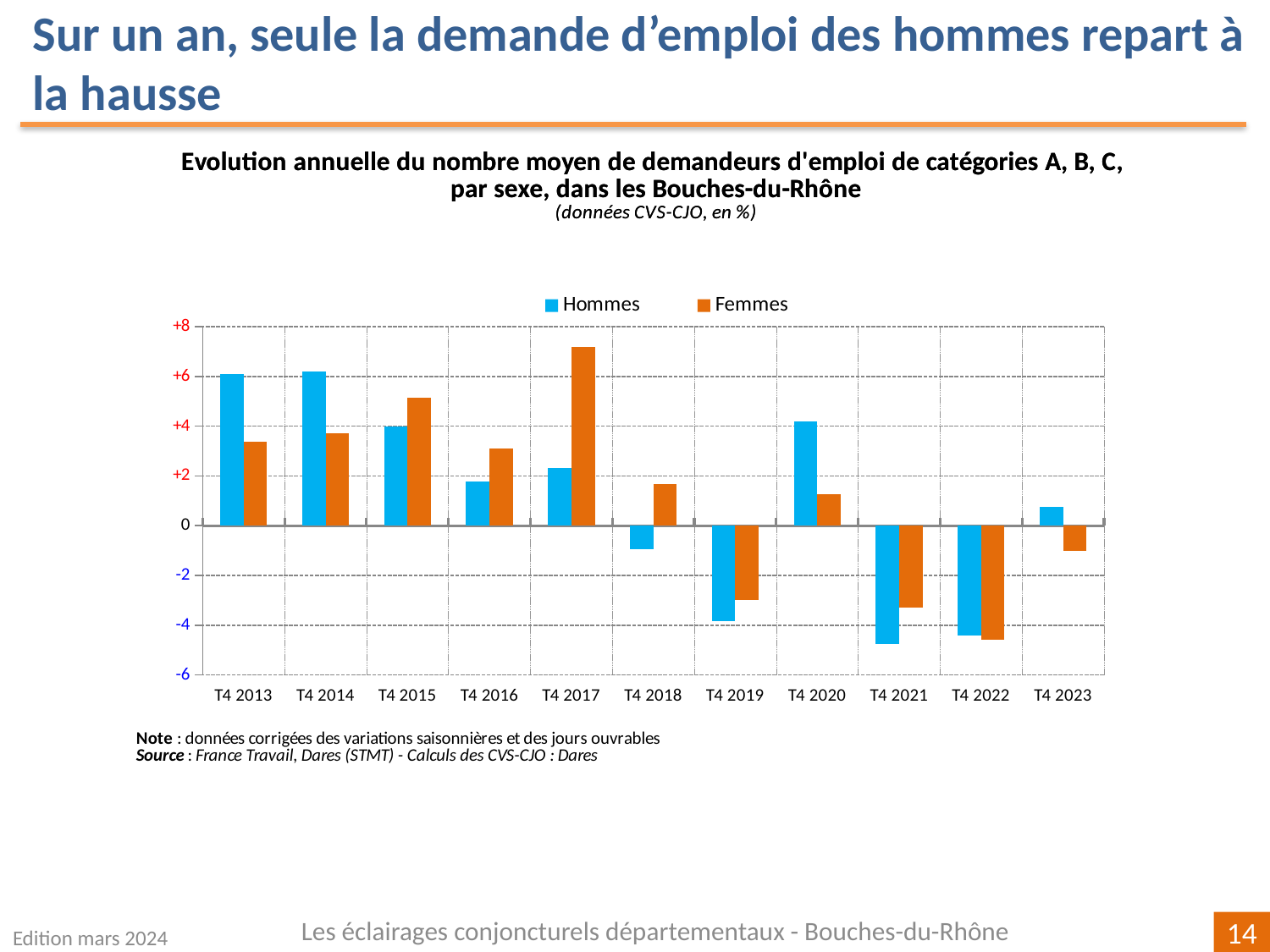
In T4 2020, which series has the larger value, Hommes or Femmes? Hommes Is the value for Hommes in T4 2019 greater or less than -2? less Is the value for Hommes in T4 2013 greater or less than +4? greater What kind of chart is shown on the slide? bar chart How many quarters (categories) are shown on the x axis? 11 Is the value for Femmes in T4 2017 greater or less than +6? greater In T4 2017, which series has the larger value, Hommes or Femmes? Femmes In which quarter is the value for Femmes the lowest? T4 2022 In which quarter is the value for Femmes the highest? T4 2017 Which colour represents the Hommes series in the legend? blue How many series does the legend list? 2 Do the values for Hommes rise or fall from T4 2013 to T4 2016? fall